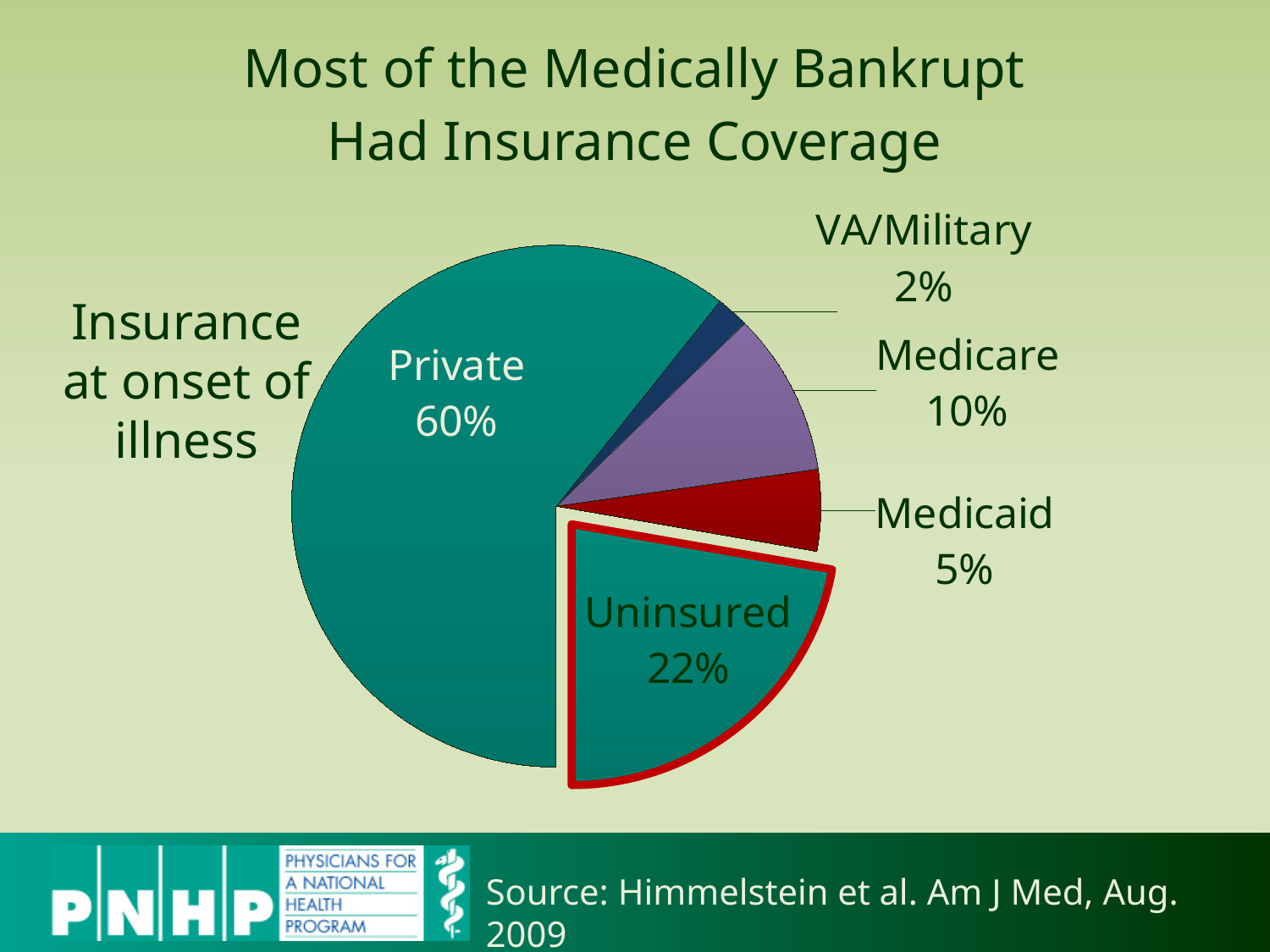
What is the value shown for Medicaid? 5% What is the difference in percentage points between Private and Uninsured? 38 How many categories are shown in the pie chart? 5 What share of the pie is Private insurance? 60% Which category has the largest slice of the pie? Private What is the value shown for VA/Military? 2% Which category has the smallest slice of the pie? VA/Military What is the value shown for Medicare? 10% Which is larger, the Medicare slice or the Medicaid slice? Medicare What percentage of the medically bankrupt were Uninsured at onset of illness? 22% What kind of chart is shown on the slide? Pie chart Which slice is pulled out from the pie and outlined in red? Uninsured